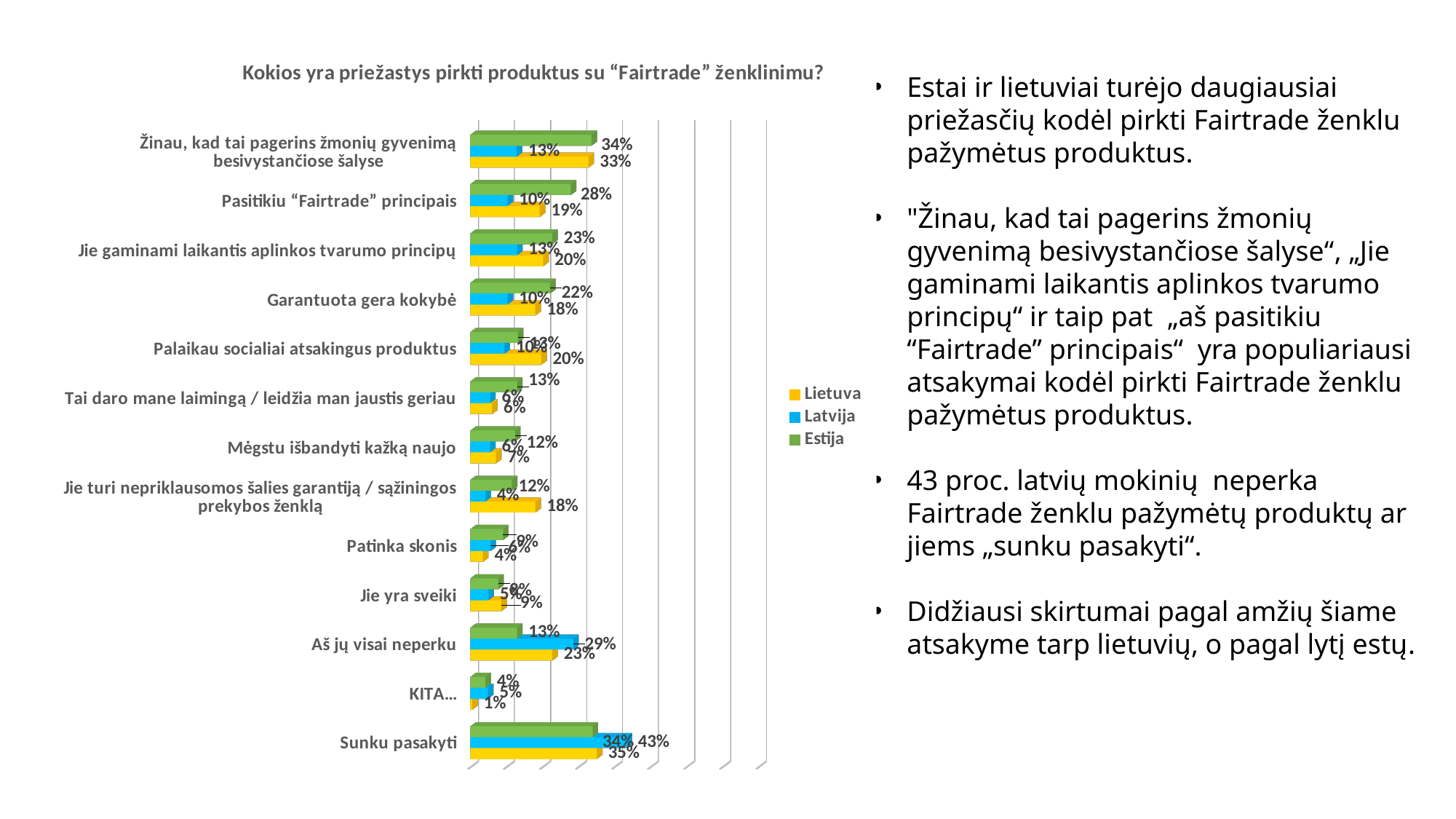
What kind of chart is shown on the slide? Bar chart For "Jie turi nepriklausomos šalies garantiją / sąžiningos prekybos ženklą", which is larger: the Lietuva value or the Latvija value? Lietuva What is the value for Latvija in the category "Aš jų visai neperku"? 29% What is the value for Latvija in the category "Sunku pasakyti"? 43% What is the value for Estija in the category "Žinau, kad tai pagerins žmonių gyvenimą besivystančiose šalyse"? 34% What is the title of the chart? Kokios yra priežastys pirkti produktus su "Fairtrade" ženklinimu? Which category has the lowest value for Lietuva? KITA... How many series does the legend list? 3 How many categories are shown on the chart? 13 What is the value for Lietuva in the category "Aš jų visai neperku"? 23% What is the difference between the Estija and Lietuva values for "Pasitikiu "Fairtrade" principais"? 9 percentage points Which category has the highest value for Latvija? Sunku pasakyti